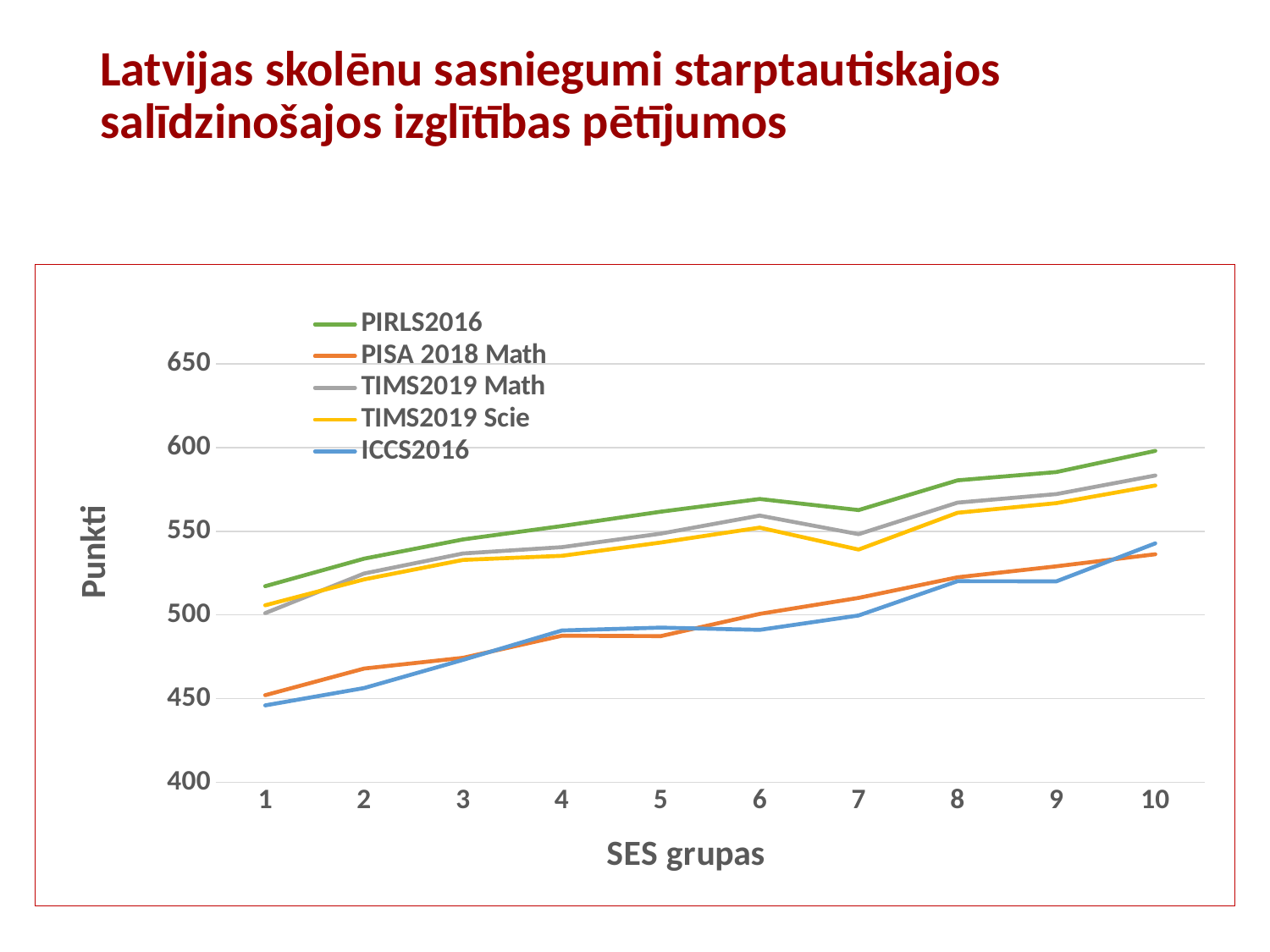
What kind of chart is shown on the slide? line chart How many SES groups are shown on the x axis? 10 Is the value for TIMS2019 Scie at SES group 7 greater or less than 550? less What is the title of the vertical axis? Punkti Is the value for ICCS2016 at SES group 1 greater or less than 500? less Do the PIRLS2016 values generally rise or fall from SES group 1 to SES group 10? rise Is the value for PIRLS2016 at SES group 1 greater or less than 500? greater At SES group 5, which is higher: PIRLS2016 or ICCS2016? PIRLS2016 Which series has the lowest value at SES group 2? ICCS2016 How many series does the legend list? 5 Which series has the highest value at SES group 10? PIRLS2016